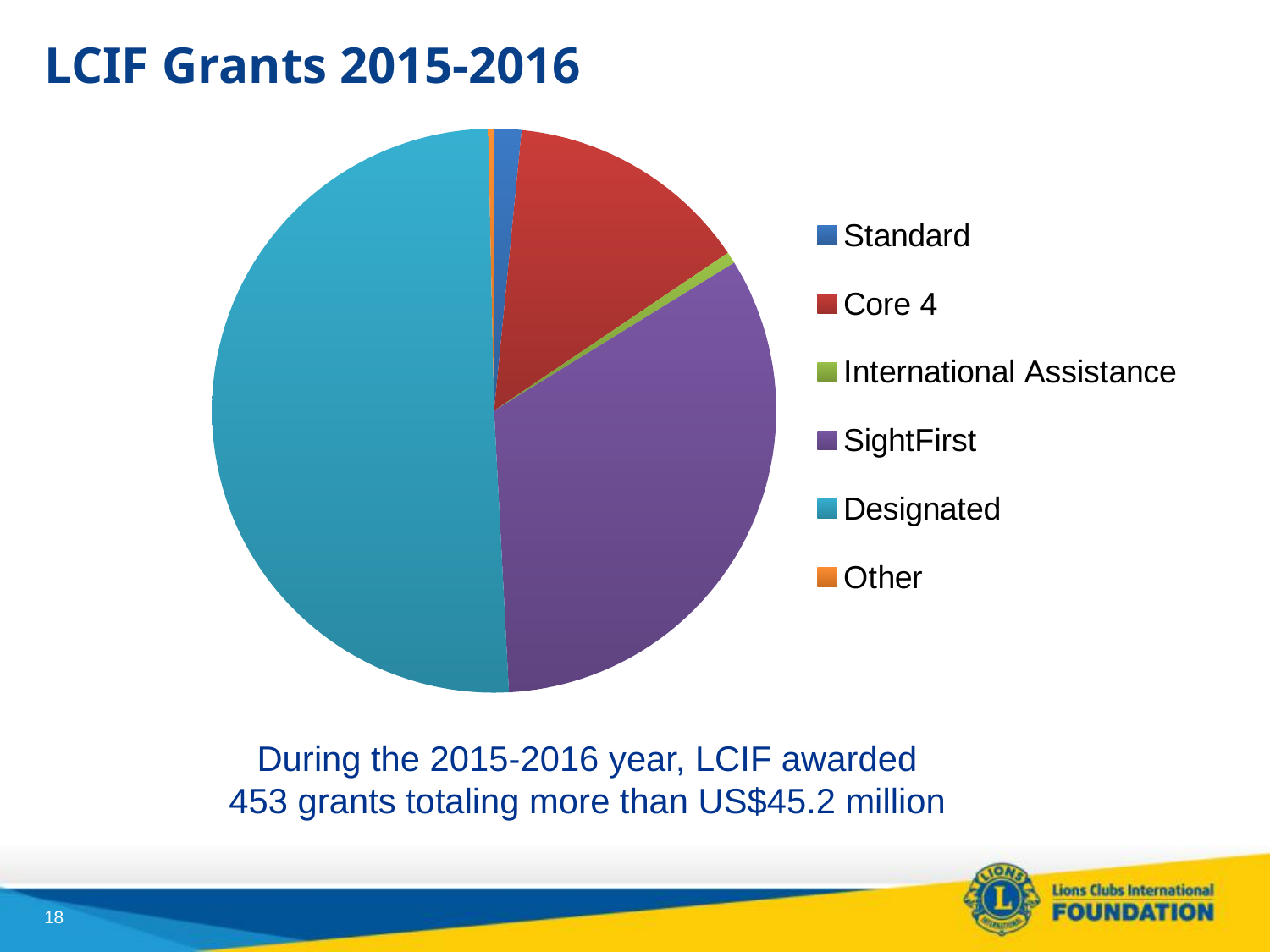
What kind of chart is shown on the slide? Pie chart Which slice is larger, Designated or SightFirst? Designated What is the title of the slide containing the pie chart? LCIF Grants 2015-2016 What colour is the Core 4 slice in the pie chart? Red Which category has the largest slice of the pie chart? Designated Which slice is larger, Core 4 or Standard? Core 4 Which slice is larger, SightFirst or Core 4? SightFirst Which category has the smallest slice of the pie chart? Other How many categories does the pie chart show? 6